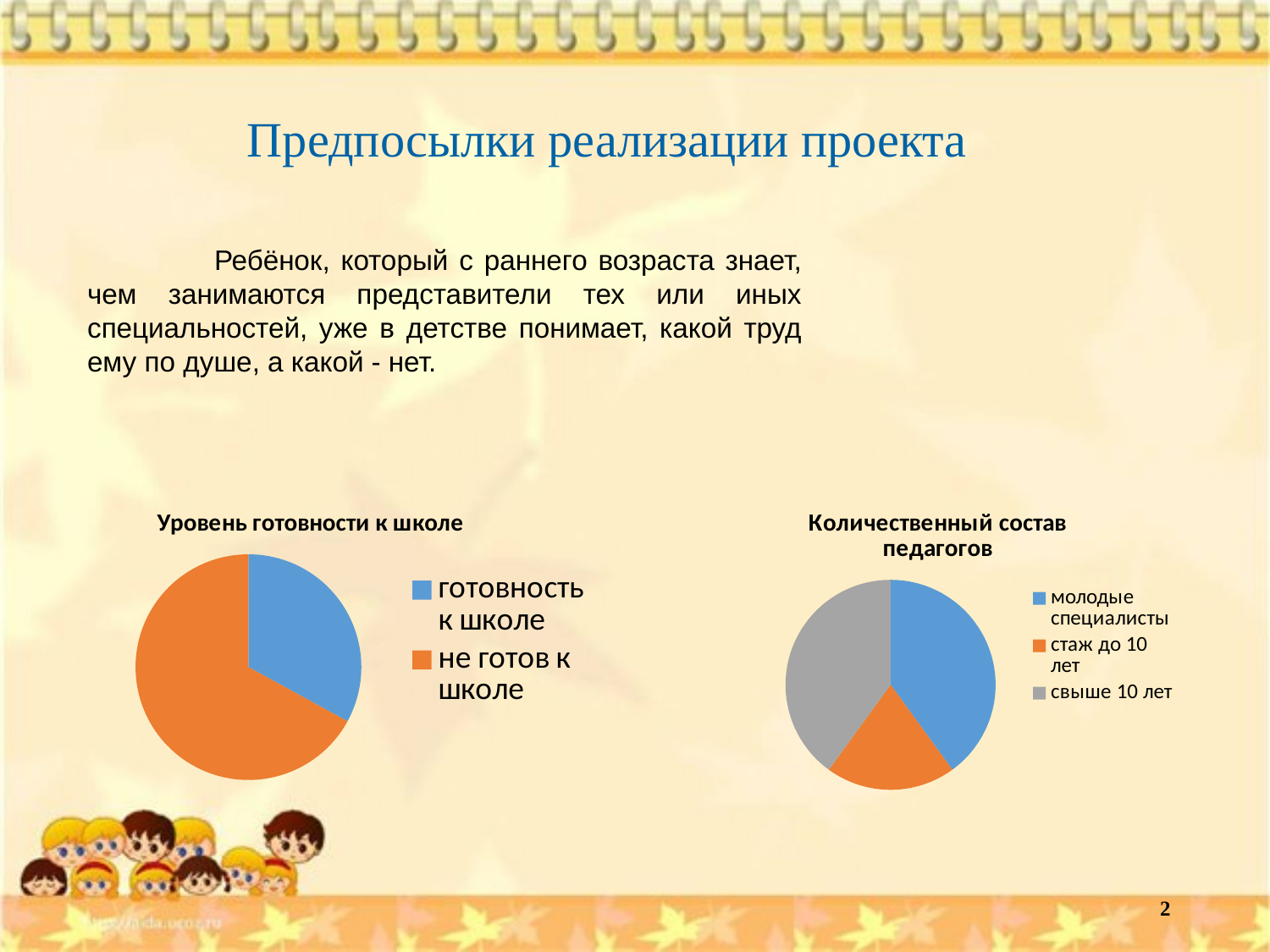
In the chart "Уровень готовности к школе", which category has the smallest slice? готовность к школе In the chart "Количественный состав педагогов", which slice is larger: "стаж до 10 лет" or "свыше 10 лет"? свыше 10 лет In the chart "Уровень готовности к школе", how many slices does the pie have? 2 In the chart "Уровень готовности к школе", which category has the largest slice? не готов к школе In the chart "Количественный состав педагогов", what colour is the slice for "свыше 10 лет"? gray How many entries does the legend of the chart "Количественный состав педагогов" list? 3 In the chart "Количественный состав педагогов", how many slices does the pie have? 3 What kind of chart is the chart titled "Количественный состав педагогов"? pie chart In the chart "Количественный состав педагогов", which category has the smallest slice? стаж до 10 лет What kind of chart is the chart titled "Уровень готовности к школе"? pie chart In the chart "Уровень готовности к школе", which slice is larger: "готовность к школе" or "не готов к школе"? не готов к школе In the chart "Количественный состав педагогов", which slice is larger: "молодые специалисты" or "стаж до 10 лет"? молодые специалисты